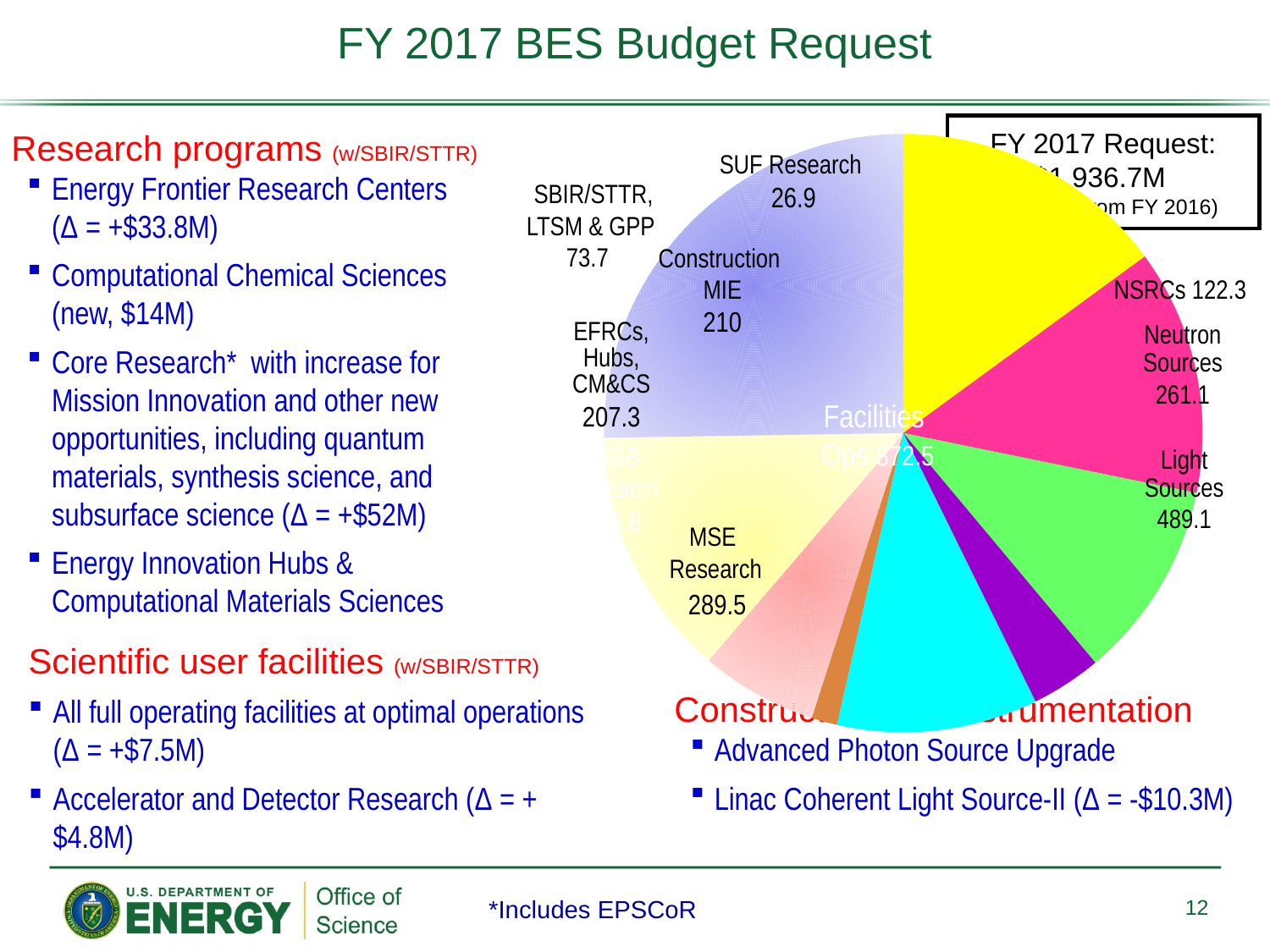
What is the difference between the values for Light Sources and Neutron Sources? 228.0 What kind of chart is shown on the slide? pie chart Which is larger, MSE Research or NSRCs? MSE Research What is the value for Neutron Sources? 261.1 What is the value for Construction MIE? 210 What is the difference between the values for MSE Research and NSRCs? 167.2 What is the value for SUF Research? 26.9 What is the value for SBIR/STTR, LTSM & GPP? 73.7 What is the value for MSE Research? 289.5 What is the value for NSRCs? 122.3 What is the value for Light Sources? 489.1 What is the value for EFRCs, Hubs, CM&CS? 207.3